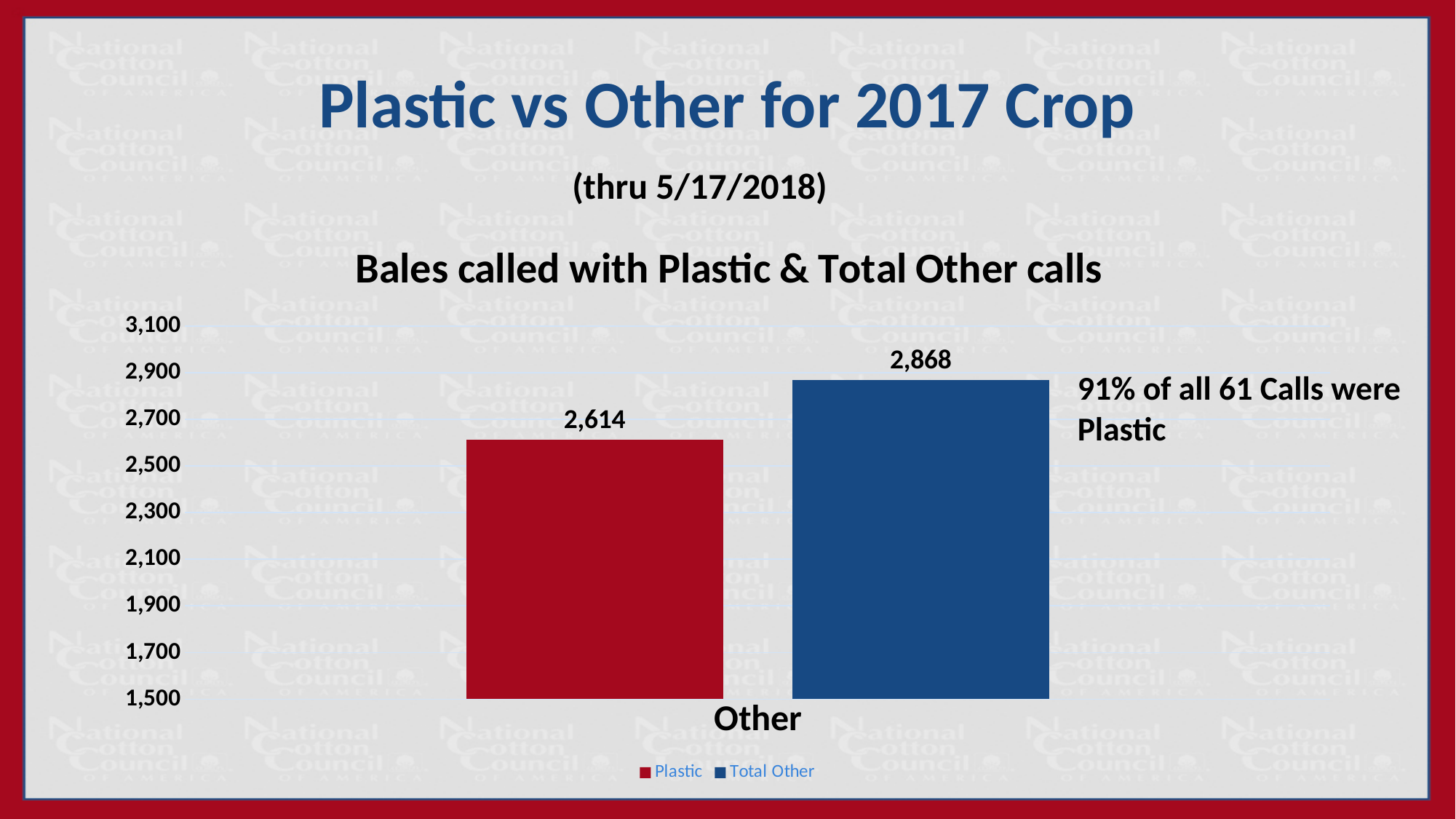
What is the value of the Total Other bar? 2,868 What is the difference between the Total Other value and the Plastic value? 254 What is the title of the chart? Bales called with Plastic & Total Other calls How many series does the legend list? 2 Which series has the higher value, Plastic or Total Other? Total Other What is the category label shown on the x axis? Other What colour is the Plastic bar? red What is the value of the Plastic bar? 2,614 What kind of chart is shown on the slide? bar chart Which series has the lowest value? Plastic Is the value for Total Other greater or less than 2,900? less Is the value for Plastic greater or less than 2,500? greater